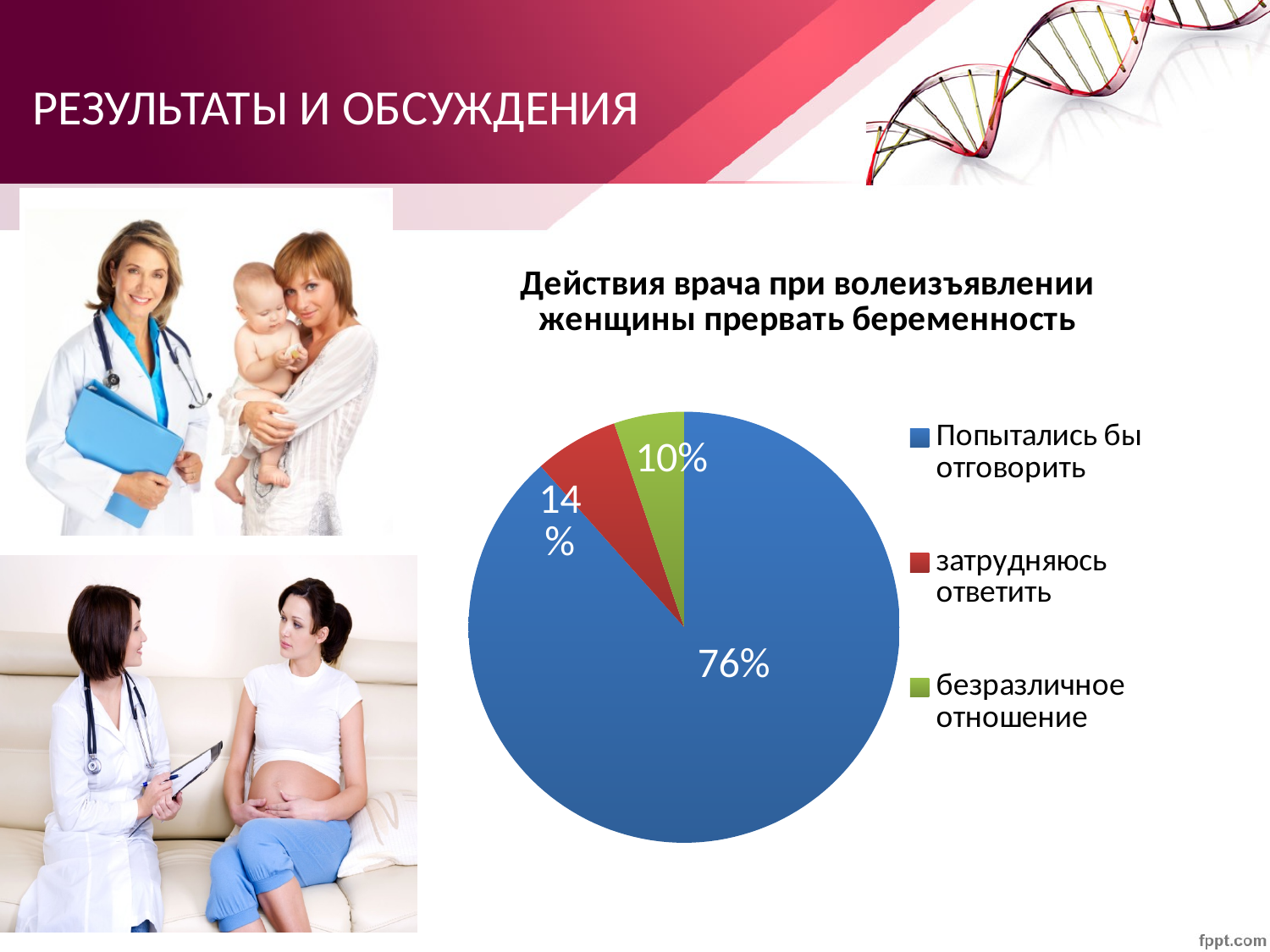
What share of the pie is labelled "Попытались бы отговорить"? 76% What is the difference in percentage points between "затрудняюсь ответить" and "безразличное отношение"? 4 How many categories does the pie chart show? 3 What is the difference in percentage points between "Попытались бы отговорить" and "затрудняюсь ответить"? 62 What share of the pie is labelled "затрудняюсь ответить"? 14% Which category has the smallest slice of the pie? безразличное отношение What is the title of the chart? Действия врача при волеизъявлении женщины прервать беременность What colour is the slice for "безразличное отношение"? green What share of the pie is labelled "безразличное отношение"? 10% What kind of chart is shown on the slide? pie chart Which is larger: the slice for "затрудняюсь ответить" or the slice for "безразличное отношение"? затрудняюсь ответить Which category has the largest slice of the pie? Попытались бы отговорить